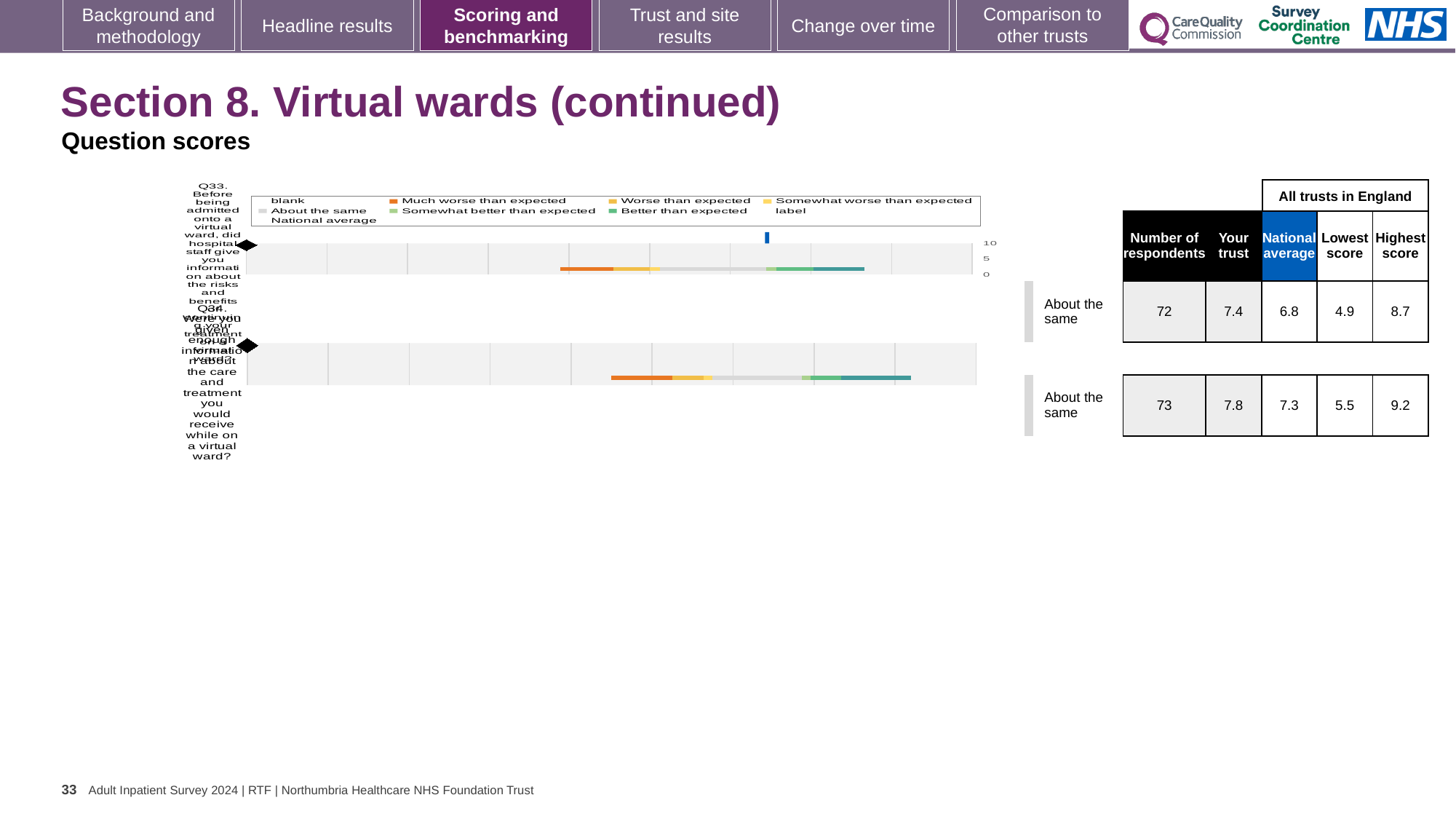
What colour represents 'Much worse than expected' in the legend? orange Which question has the higher 'Your trust' score, Q33 or Q34? Q34 What is the 'Your trust' score for Q33 (information about the risks and benefits of a virtual ward)? 7.4 How many questions (categories) are plotted in the chart? 2 How much higher is the trust's score than the national average for Q33? 0.6 What kind of chart is shown on the slide? bar chart What is the difference between the highest and lowest scores for Q34? 3.7 What is the lowest score among all trusts in England for Q34? 5.5 What is the highest score among all trusts in England for Q33? 8.7 How many respondents answered Q34? 73 What benchmarking category is shown for Q33? About the same What is the national average score for Q34 (enough information about care and treatment on a virtual ward)? 7.3